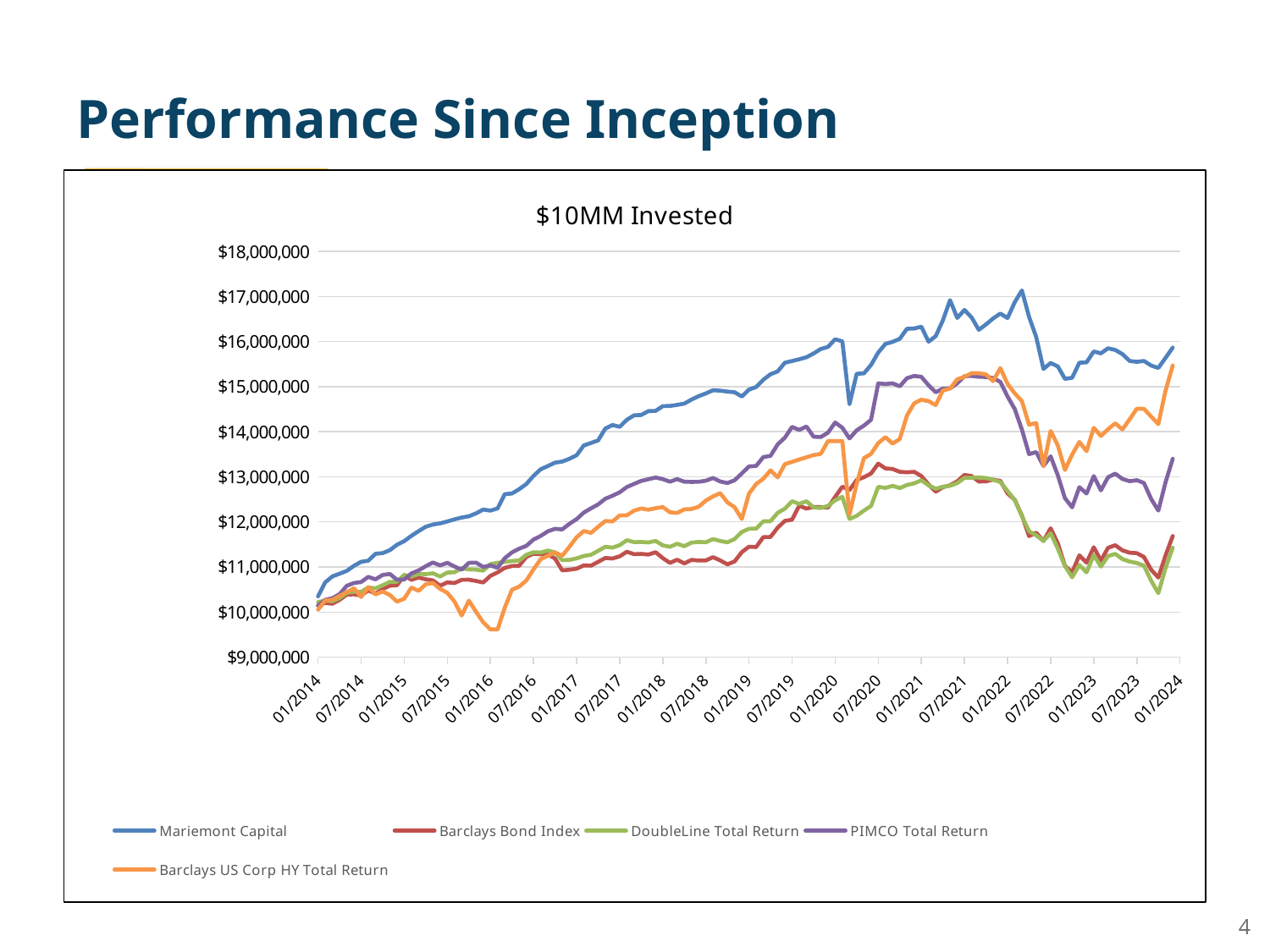
Is the value for Mariemont Capital at 07/2021 greater or less than $16,000,000? greater Which series reaches the highest value at any point on the chart? Mariemont Capital What type of chart is shown on the slide? Line chart Is the value for Barclays US Corp HY Total Return at 01/2016 greater or less than $10,000,000? less How many series does the legend list? 5 Does the Mariemont Capital line generally rise or fall from 01/2014 to 01/2020? Rise Is the value for Mariemont Capital at 01/2024 greater or less than $15,000,000? greater At 01/2024, which is larger: Mariemont Capital or PIMCO Total Return? Mariemont Capital What colour is the Mariemont Capital line? Blue What is the title of the chart? $10MM Invested At 01/2019, which is larger: PIMCO Total Return or Barclays Bond Index? PIMCO Total Return